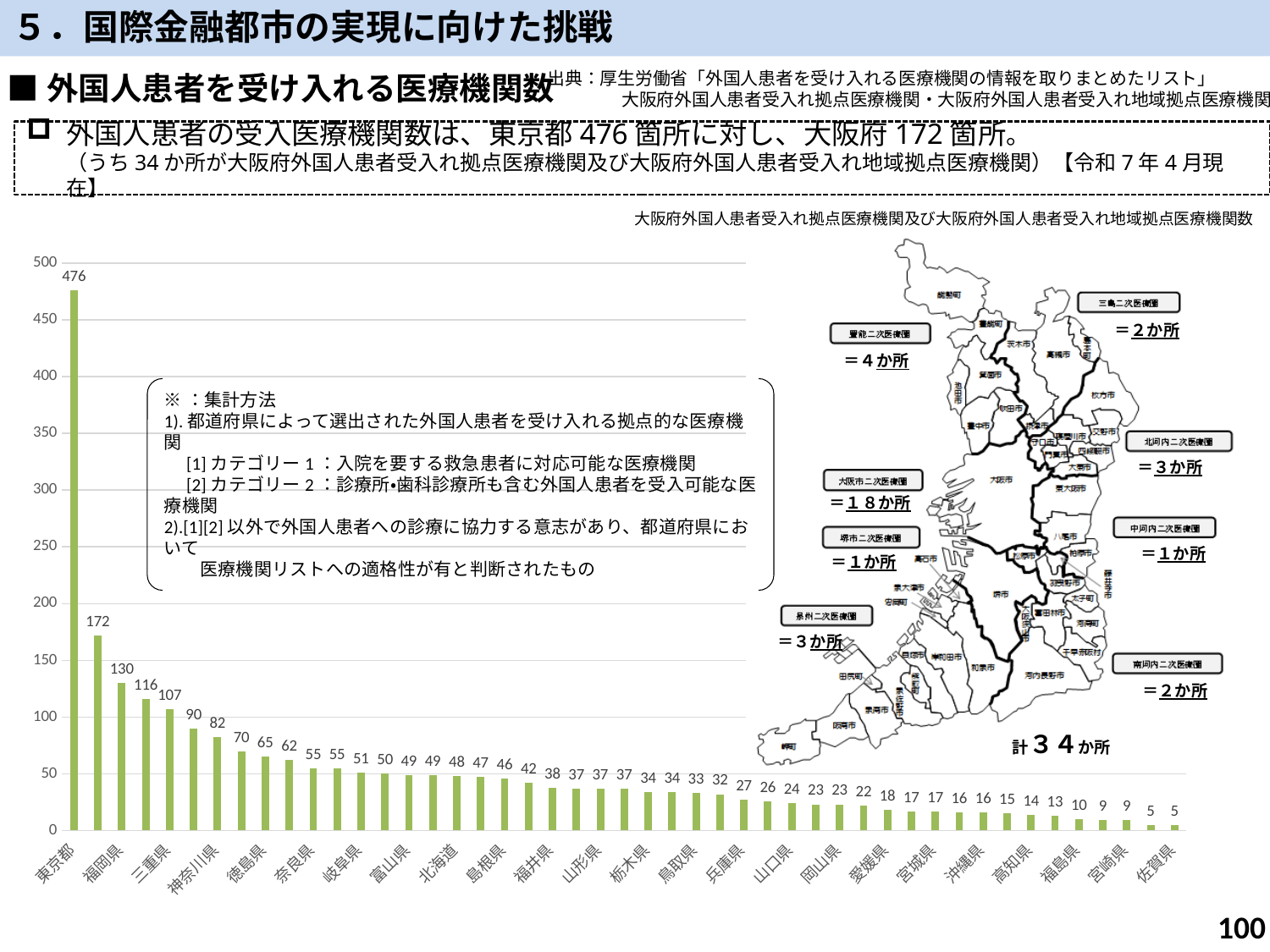
What is the highest tick value shown on the vertical axis of the bar chart? 500 What is the value for 福岡県 in the bar chart? 130 Do the values rise or fall from left to right along the x axis? fall Which prefecture has the highest value in the bar chart? 東京都 What is the value for 佐賀県 in the bar chart? 5 What is the value for 兵庫県 in the bar chart? 27 What is the value for 東京都 in the bar chart? 476 What is the difference between the values for 東京都 and 福岡県? 346 Which has the larger value, 福岡県 or 徳島県? 福岡県 Is the value for 北海道 greater or less than 50? less What kind of chart is shown on the slide? bar chart Which has the larger value, 三重県 or 神奈川県? 三重県